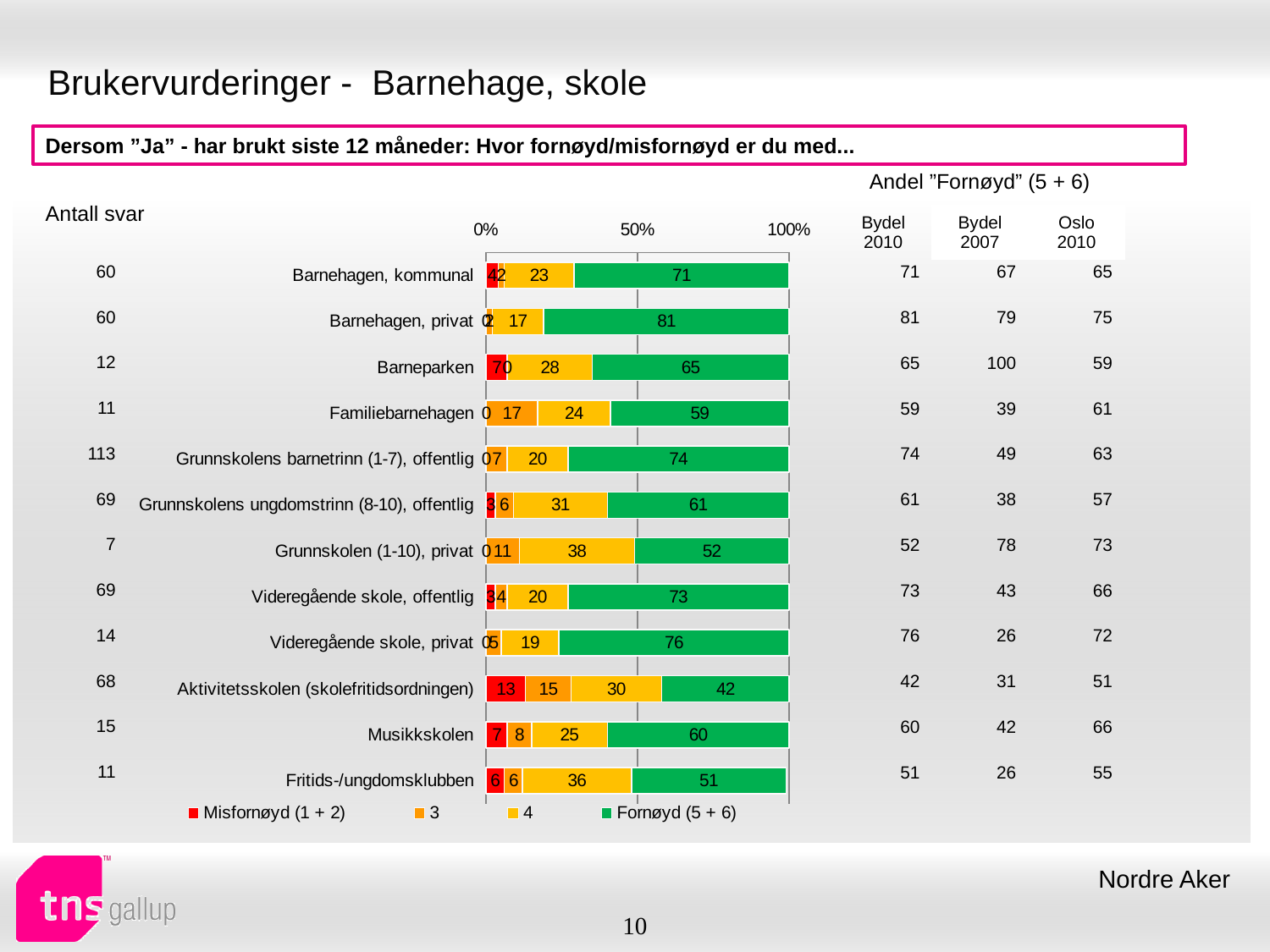
Which category has the highest Fornøyd (5 + 6) value? Barnehagen, privat How many categories (rows) are plotted in the chart? 12 What legend label is shown for the green segments? Fornøyd (5 + 6) What is the Misfornøyd (1 + 2) value for Aktivitetsskolen (skolefritidsordningen)? 13 How many series does the chart legend list? 4 Which has the larger Fornøyd (5 + 6) value: Musikkskolen or Fritids-/ungdomsklubben? Musikkskolen What is the difference between the Fornøyd (5 + 6) values for Barnehagen, privat and Barnehagen, kommunal? 10 What is the Fornøyd (5 + 6) value for Barnehagen, kommunal? 71 Which category has the lowest Fornøyd (5 + 6) value? Aktivitetsskolen (skolefritidsordningen) What is the value of the '4' segment for Grunnskolen (1-10), privat? 38 What kind of chart is shown on the slide? bar chart What is the total of the stacked bar for Aktivitetsskolen (skolefritidsordningen)? 100